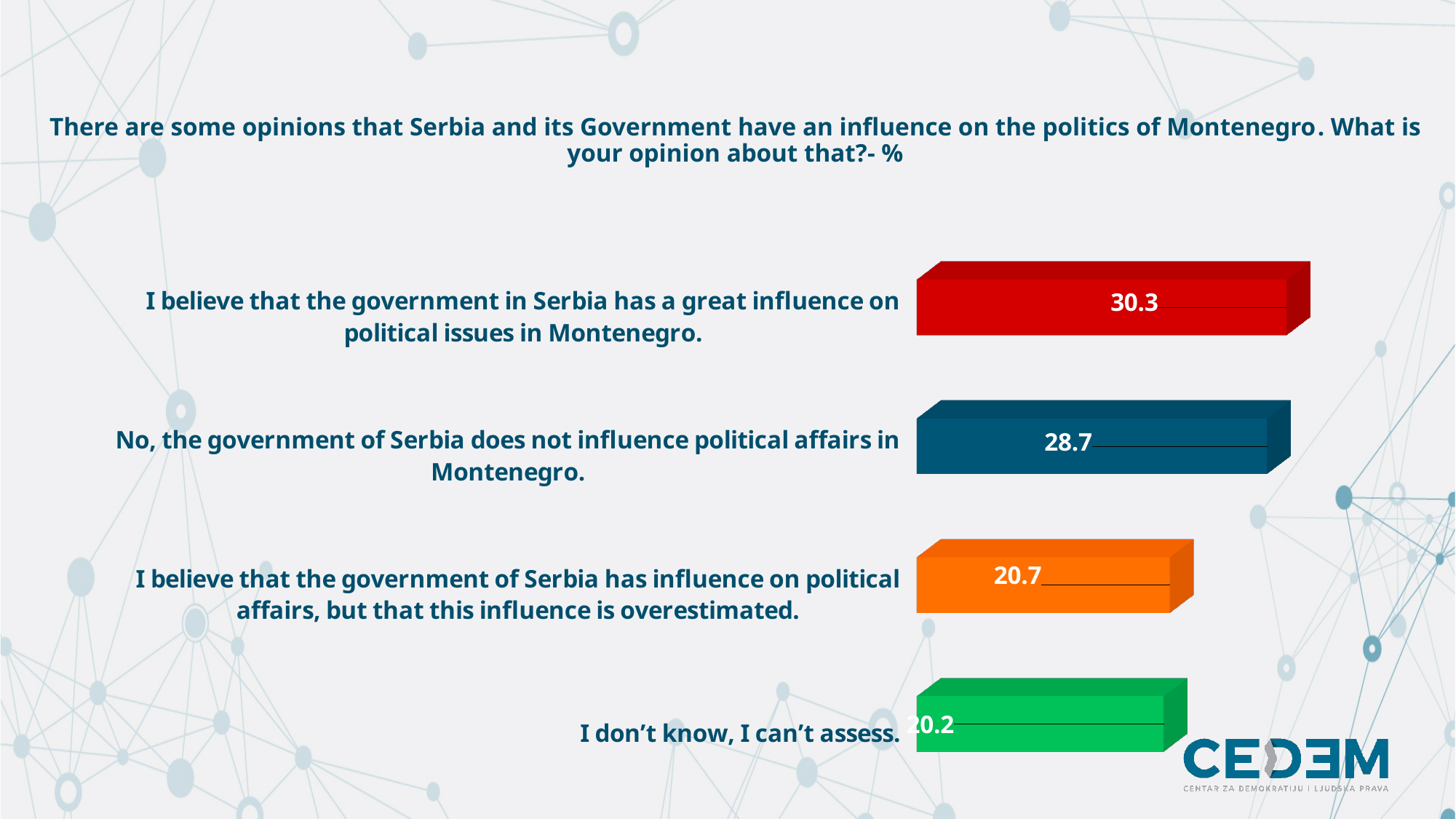
Which response option has the highest value? I believe that the government in Serbia has a great influence on political issues in Montenegro. What value is shown for "No, the government of Serbia does not influence political affairs in Montenegro"? 28.7 What percentage of respondents believe that the government in Serbia has a great influence on political issues in Montenegro? 30.3 What type of chart is shown on the slide? bar chart Which response option has the lowest value? I don't know, I can't assess. What percentage of respondents believe the government of Serbia has influence on political affairs but that this influence is overestimated? 20.7 What is the difference between the value for "influence is overestimated" and the value for "I don't know, I can't assess"? 0.5 What is the difference between the value for "great influence" (30.3) and the value for "does not influence" (28.7)? 1.6 How many response categories are shown in the chart? 4 Which is larger: the value for "influence is overestimated" or the value for "I don't know, I can't assess"? influence is overestimated What value is shown for "I don't know, I can't assess"? 20.2 What colour is the bar for "I don't know, I can't assess"? green